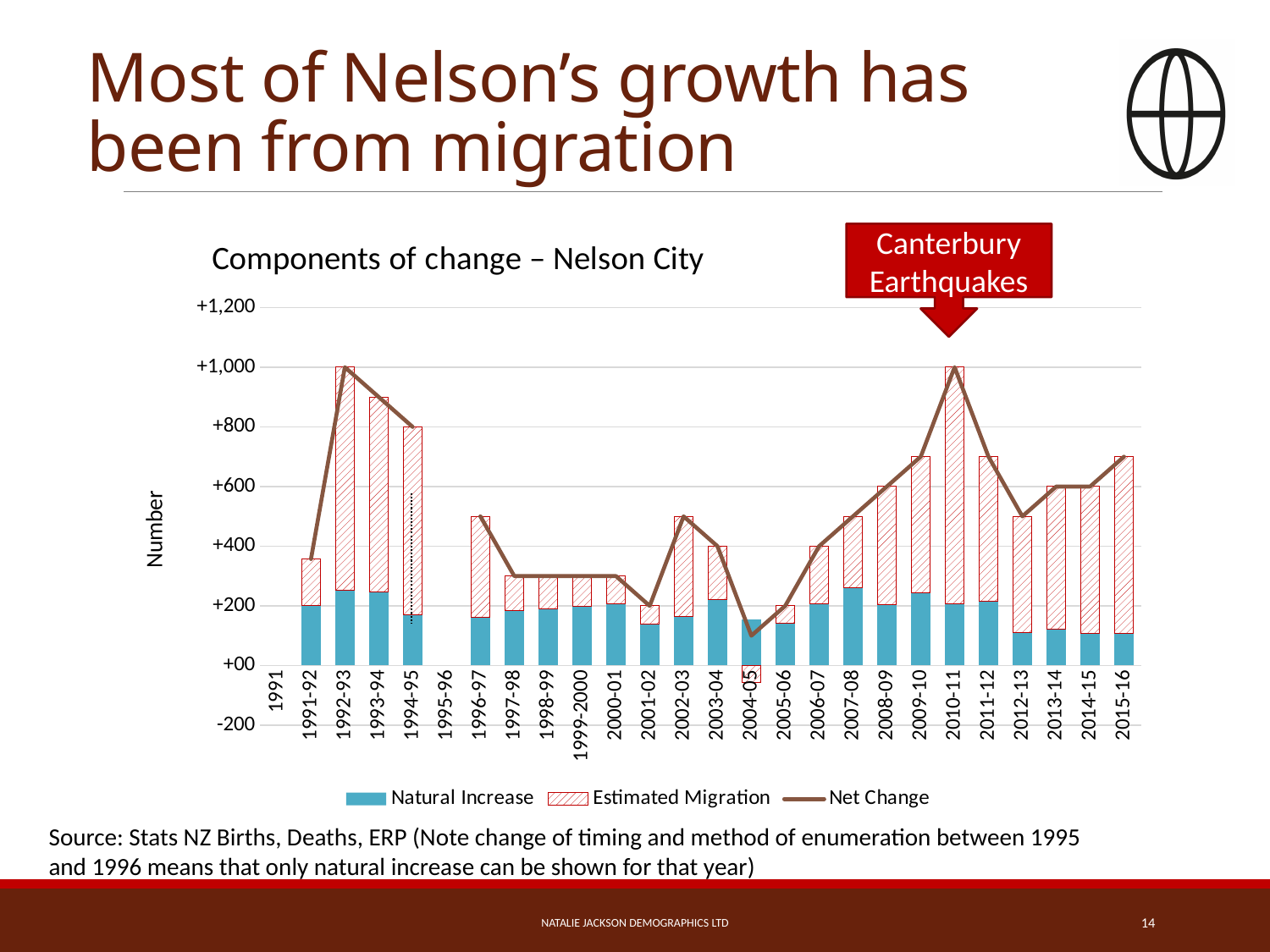
What kind of chart is shown on the slide? Bar chart with a line Which series are listed in the chart legend? Natural Increase, Estimated Migration, Net Change What is the Net Change value for 2010-11? +1,000 Which year has the lowest Net Change value? 2004-05 Is the Estimated Migration value for 2004-05 greater or less than 0? less Is the Net Change value for 2004-05 greater or less than 200? less How many year categories are labelled on the x axis? 26 Does the Net Change line rise or fall from 2004-05 to 2010-11? rise Is the Natural Increase value for 2012-13 greater or less than 200? less What is the title of the chart? Components of change – Nelson City Which year has the larger Net Change value, 1992-93 or 1994-95? 1992-93 How many series does the chart legend list? 3